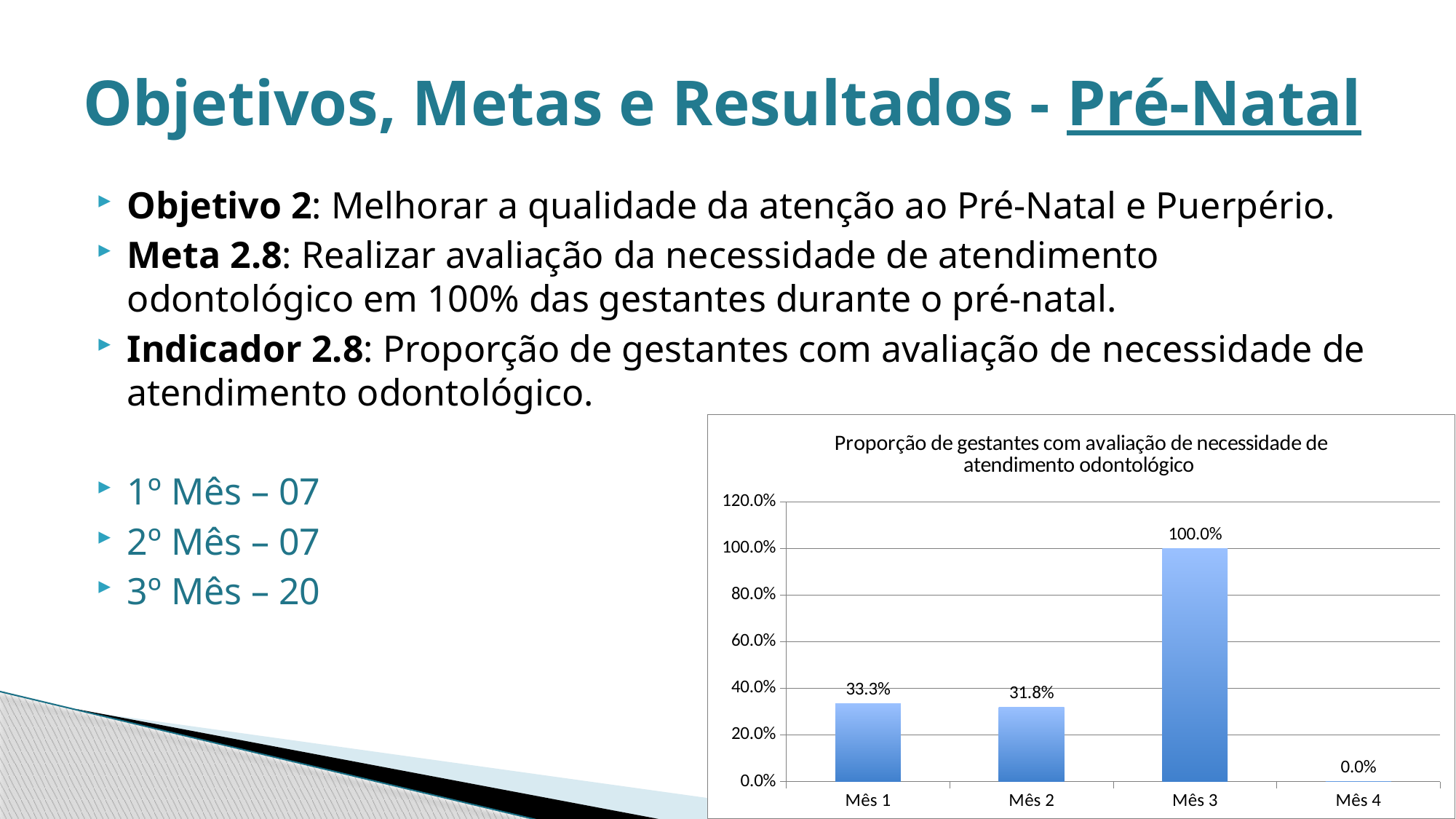
What is the difference between the values for Mês 1 and Mês 2? 1.5% Which is larger, the value for Mês 1 or the value for Mês 2? Mês 1 Which month has the lowest value? Mês 4 What is the value for Mês 3? 100.0% How many months are shown on the x axis of the chart? 4 What is the value for Mês 1? 33.3% What is the title of the chart? Proporção de gestantes com avaliação de necessidade de atendimento odontológico What is the value for Mês 4? 0.0% Which month has the highest value? Mês 3 What kind of chart is shown on the slide? Bar chart What is the value for Mês 2? 31.8% What is the difference between the values for Mês 3 and Mês 1? 66.7%